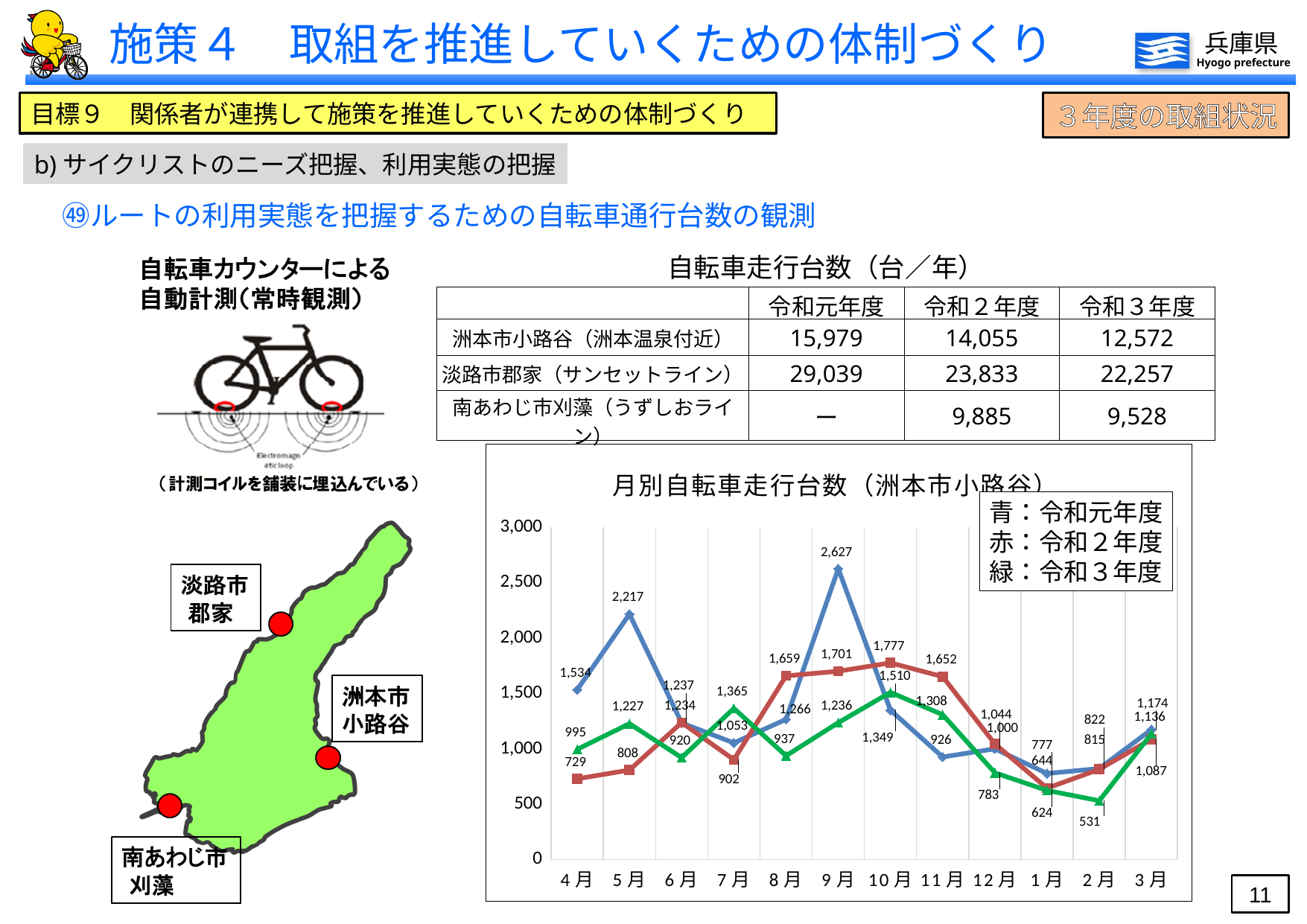
In the 月別自転車走行台数 chart, which month has the lowest value for 令和3年度 (green)? 2月 In the 月別自転車走行台数 chart, is the 令和元年度 (blue) value in 9月 greater or less than 2,500? greater In the 月別自転車走行台数 chart, what is the value for 令和3年度 (green) in 4月? 995 How many months are shown on the x axis of the 月別自転車走行台数 chart? 12 In the 月別自転車走行台数 chart, what is the difference between the 令和元年度 (blue) and 令和2年度 (red) values in 5月? 1,409 In the 月別自転車走行台数 chart, what is the value for 令和元年度 (blue) in 9月? 2,627 In the 月別自転車走行台数 chart, which is larger in 4月: 令和元年度 (blue) or 令和2年度 (red)? 令和元年度 (blue) How many series does the legend of the 月別自転車走行台数 chart list? 3 In the 月別自転車走行台数 chart, which colour represents 令和2年度? 赤 (red) What kind of chart is 月別自転車走行台数（洲本市小路谷）? line chart In the 月別自転車走行台数 chart, which month has the highest value for 令和元年度 (blue)? 9月 In the 月別自転車走行台数 chart, what is the value for 令和2年度 (red) in 10月? 1,777